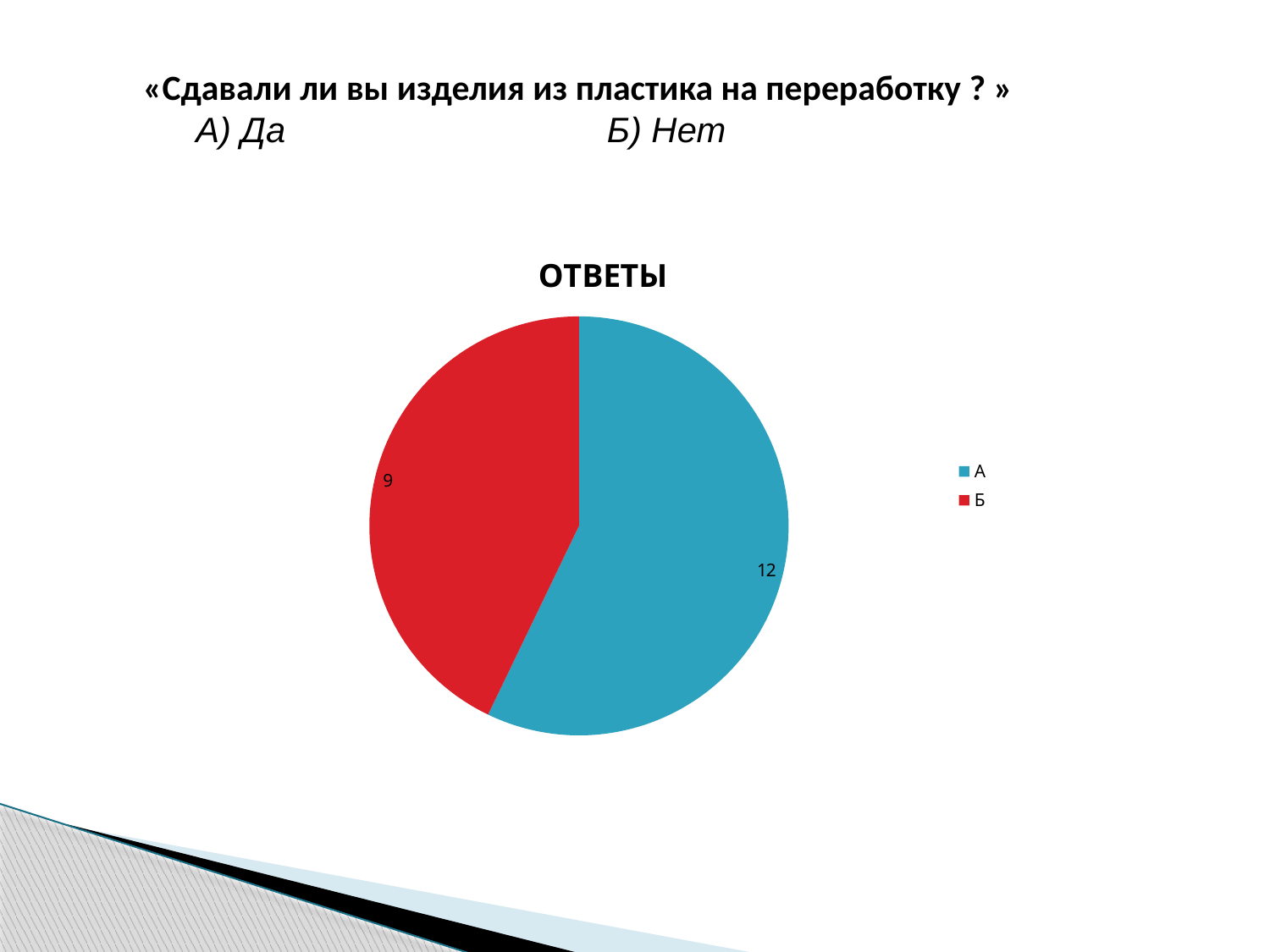
Which is larger, the value for А or the value for Б? А What colour is the slice for category Б? red Which category has the largest slice? А What is the total of all slices in the pie chart? 21 What type of chart is shown on the slide? pie chart What is the difference between the values for А and Б? 3 What is the value for category А? 12 What is the value for category Б? 9 How many entries does the legend list? 2 How many slices does the pie chart have? 2 What is the title of the chart? ОТВЕТЫ Which category has the smallest slice? Б